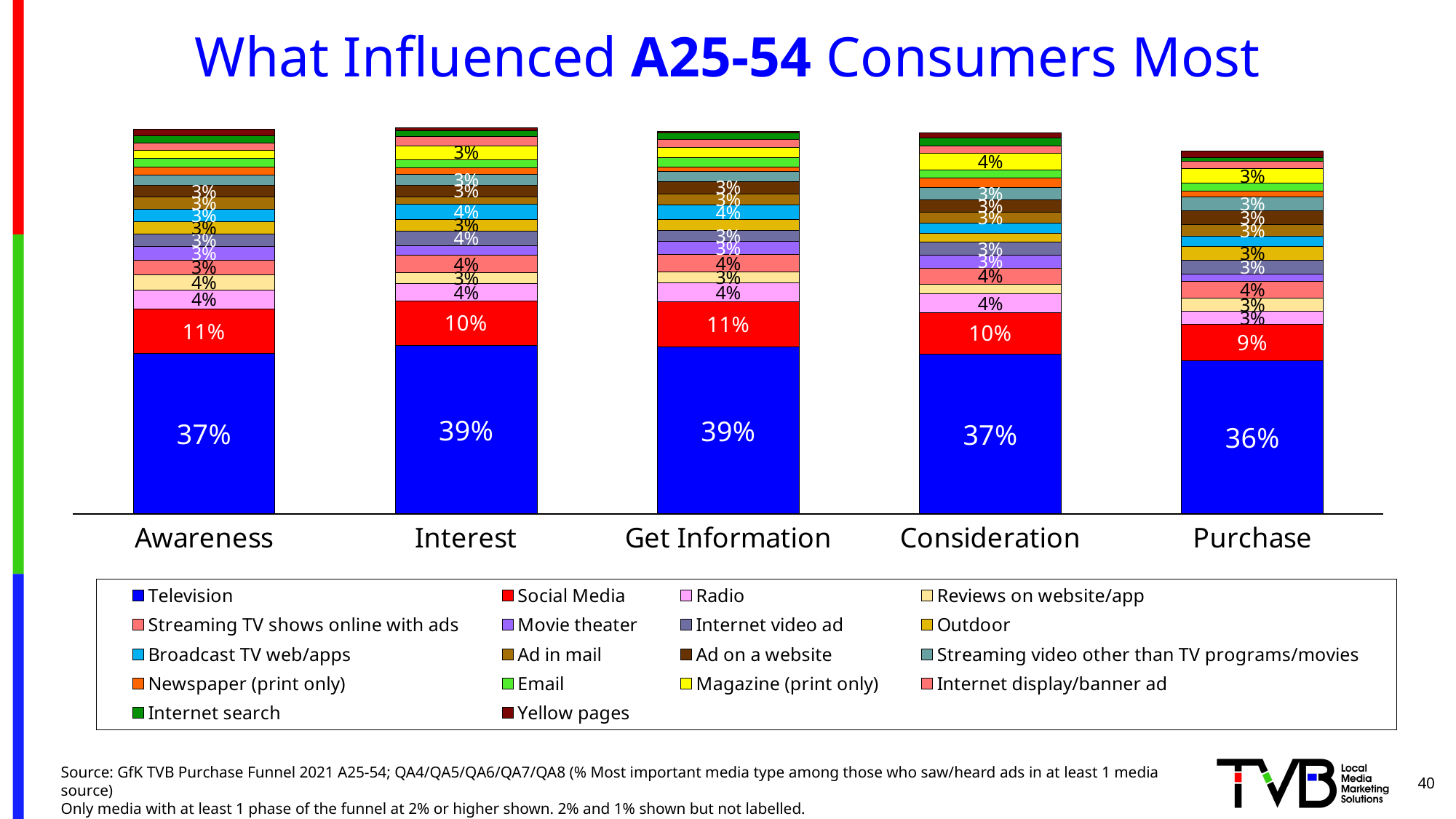
What is the Magazine (print only) value for the Consideration stage? 4% How many series does the legend list? 18 What kind of chart is shown on the slide? Stacked bar chart What is the difference between the Television value for Interest and the Television value for Purchase? 3 percentage points How many funnel stages are shown on the x axis? 5 What is the title of the slide? What Influenced A25-54 Consumers Most What is the Social Media value for the Get Information stage? 11% What is the Television value for the Purchase stage? 36% Which funnel stage has the lowest Television value? Purchase What is the Social Media value for the Purchase stage? 9% Which stage has the larger Social Media value, Awareness or Purchase? Awareness What is the Television value for the Awareness stage? 37%